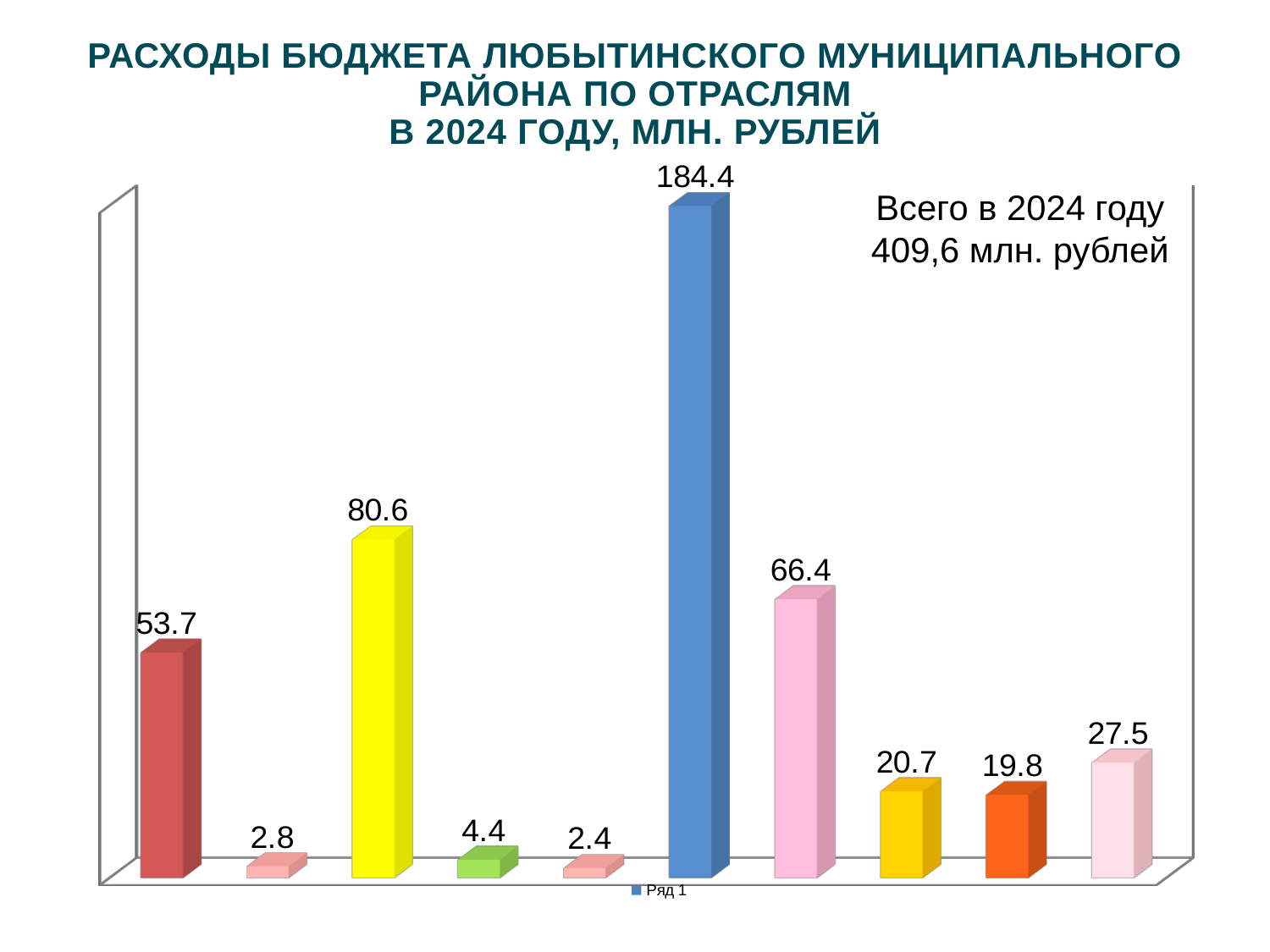
How many bars are plotted in the chart? 10 What is the value of the last bar on the right? 27.5 What is the legend entry shown below the chart? Ряд 1 How many series does the legend list? 1 What type of chart is shown on the slide? bar chart What is the value of the yellow bar, the third from the left? 80.6 Which is larger: the gold bar labelled 20.7 or the orange bar labelled 19.8? 20.7 What is the difference between the blue bar (184.4) and the yellow bar (80.6)? 103.8 What is the value of the first (red) bar on the left? 53.7 What total expenditure for 2024 is stated in the text on the slide? 409,6 млн. рублей What is the value of the shortest bar in the chart? 2.4 What is the value of the tallest bar (the blue one)? 184.4